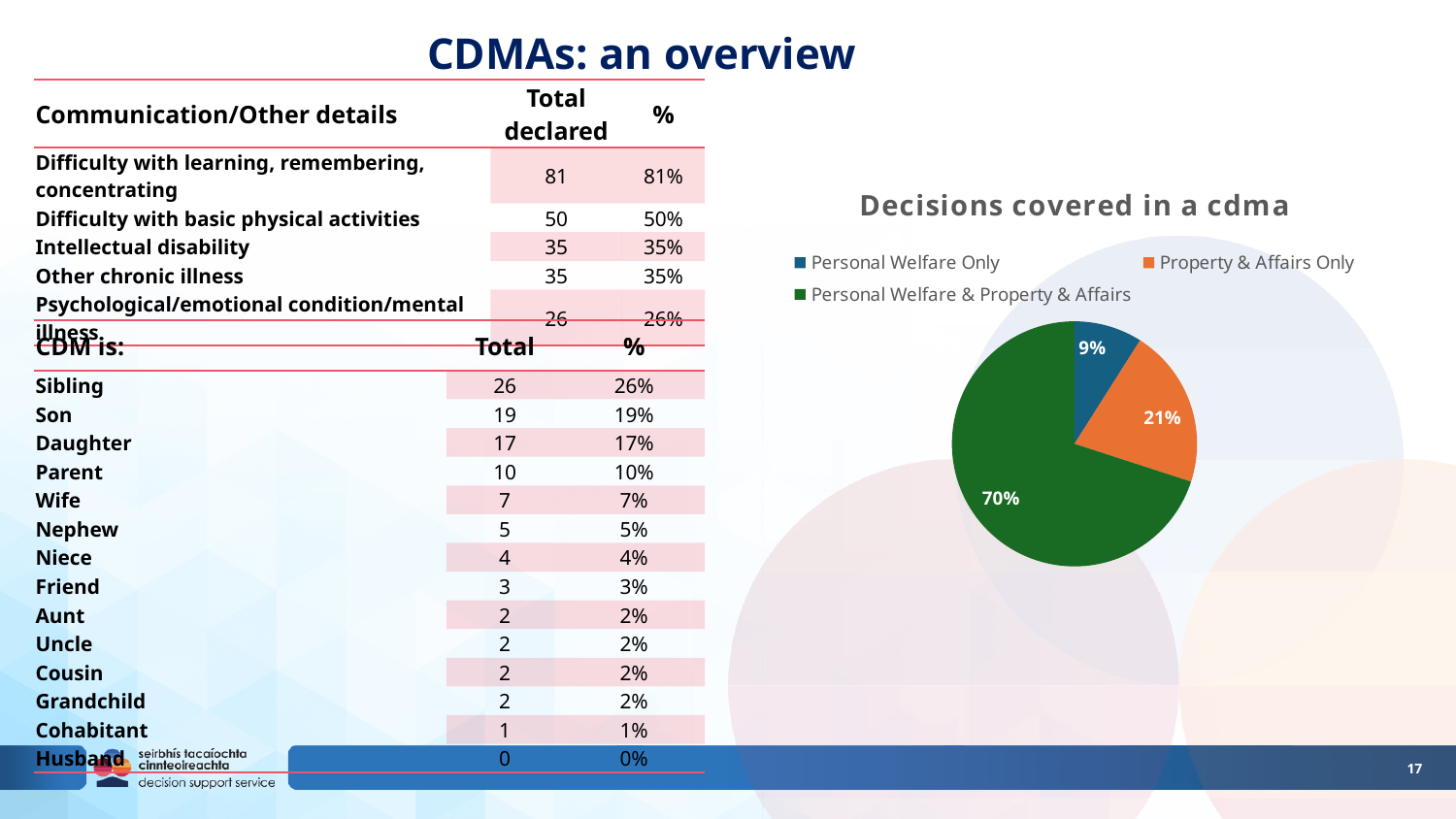
What is the difference in percentage points between the Personal Welfare & Property & Affairs slice and the Property & Affairs Only slice? 49 What colour is the Personal Welfare Only slice in the pie chart? blue How many slices does the pie chart have? 3 What kind of chart is shown on the slide? pie chart Which is larger in the pie chart: Property & Affairs Only or Personal Welfare Only? Property & Affairs Only What share of the pie is Personal Welfare & Property & Affairs? 70% Which category has the smallest slice of the pie chart? Personal Welfare Only Which category has the largest slice of the pie chart? Personal Welfare & Property & Affairs What is the title of the pie chart? Decisions covered in a cdma What share of the pie is Personal Welfare Only? 9% What share of the pie is Property & Affairs Only? 21% How many entries does the pie chart's legend list? 3